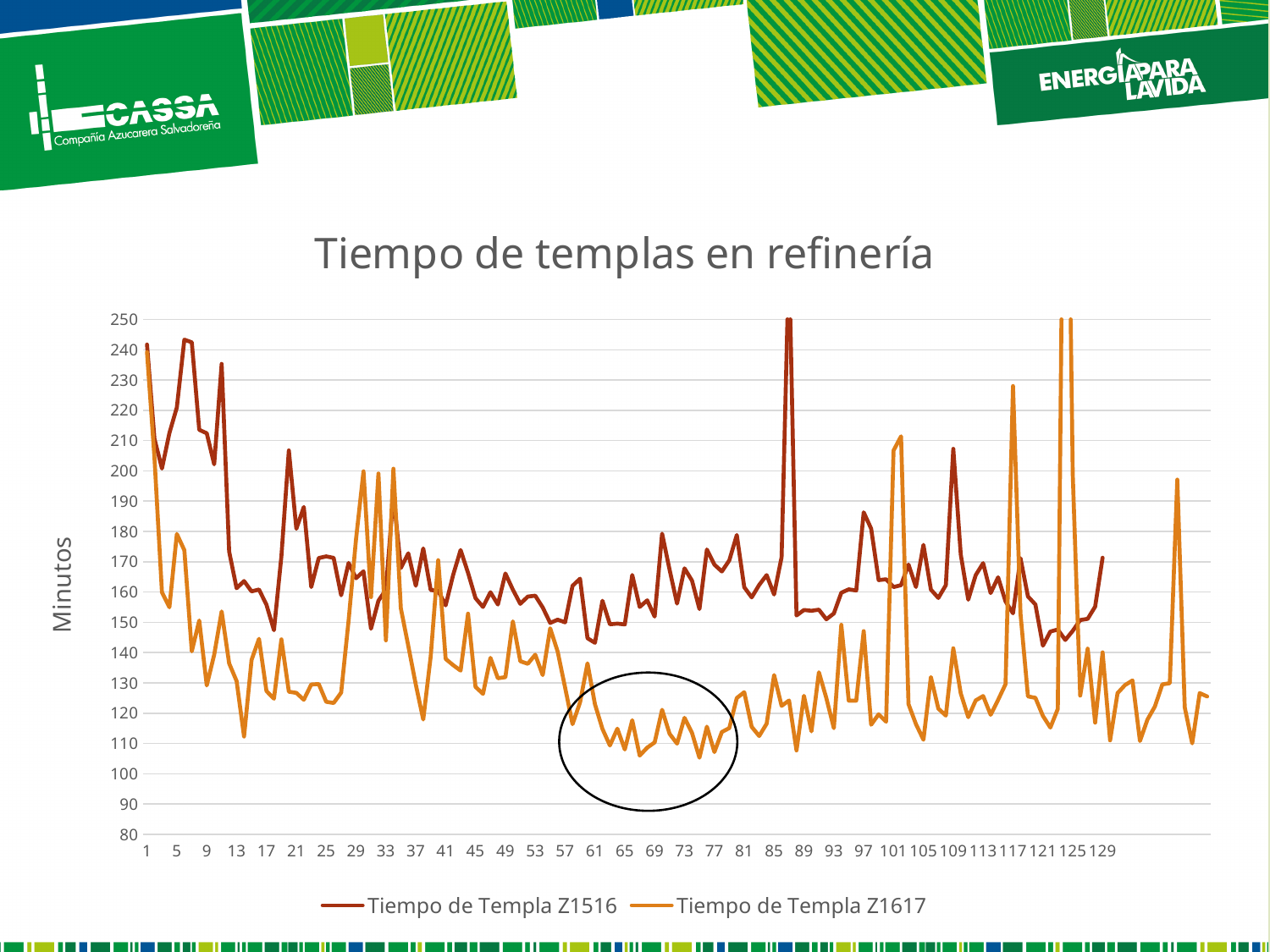
Is the value for Tiempo de Templa Z1516 at point 87 greater or less than 240? greater At point 101, which series has the larger value, Tiempo de Templa Z1516 or Tiempo de Templa Z1617? Tiempo de Templa Z1617 What kind of chart is shown on the slide? Line chart Overall, does the Tiempo de Templa Z1617 line rise or fall from point 1 to point 129? fall Is the value for Tiempo de Templa Z1617 at point 69 greater or less than 120? less At point 13, which series has the larger value, Tiempo de Templa Z1516 or Tiempo de Templa Z1617? Tiempo de Templa Z1516 What is the title of the chart? Tiempo de templas en refinería Is the value for Tiempo de Templa Z1516 at point 109 greater or less than 200? greater What is the label on the vertical axis of the chart? Minutos How many series does the legend list? 2